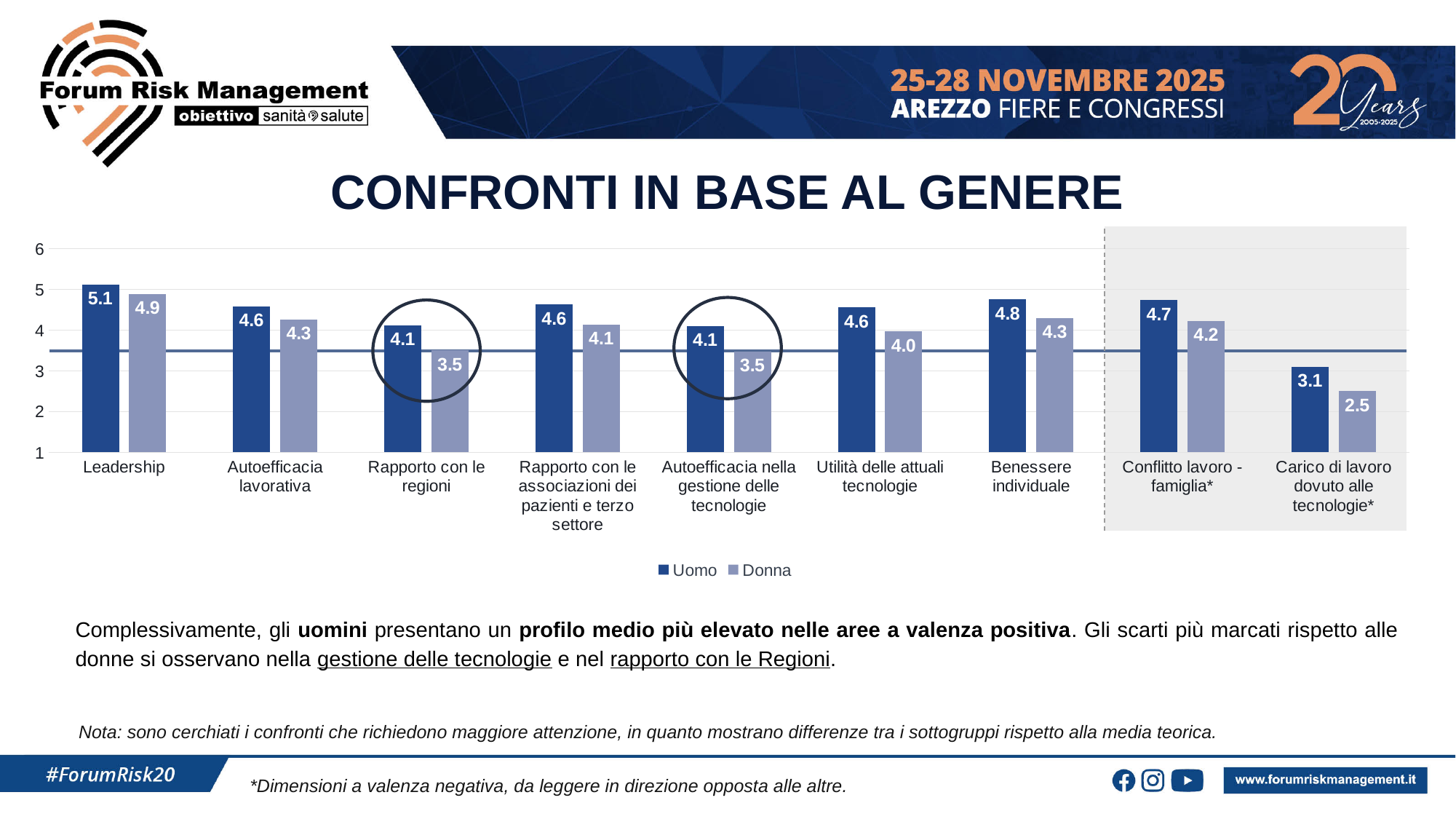
How many categories are shown on the x axis? 9 Is the Donna value for Carico di lavoro dovuto alle tecnologie* greater or less than 3? less How many series does the legend list? 2 What is the difference between the Uomo and Donna values for Autoefficacia nella gestione delle tecnologie? 0.6 What is the Donna value for Utilità delle attuali tecnologie? 4.0 What is the Uomo value for Leadership? 5.1 Which is larger for Benessere individuale, the Uomo value or the Donna value? Uomo What is the Donna value for Rapporto con le regioni? 3.5 What kind of chart is shown on the slide? Bar chart Which category has the lowest Donna value? Carico di lavoro dovuto alle tecnologie* What is the Uomo value for Carico di lavoro dovuto alle tecnologie*? 3.1 Which category has the highest Uomo value? Leadership